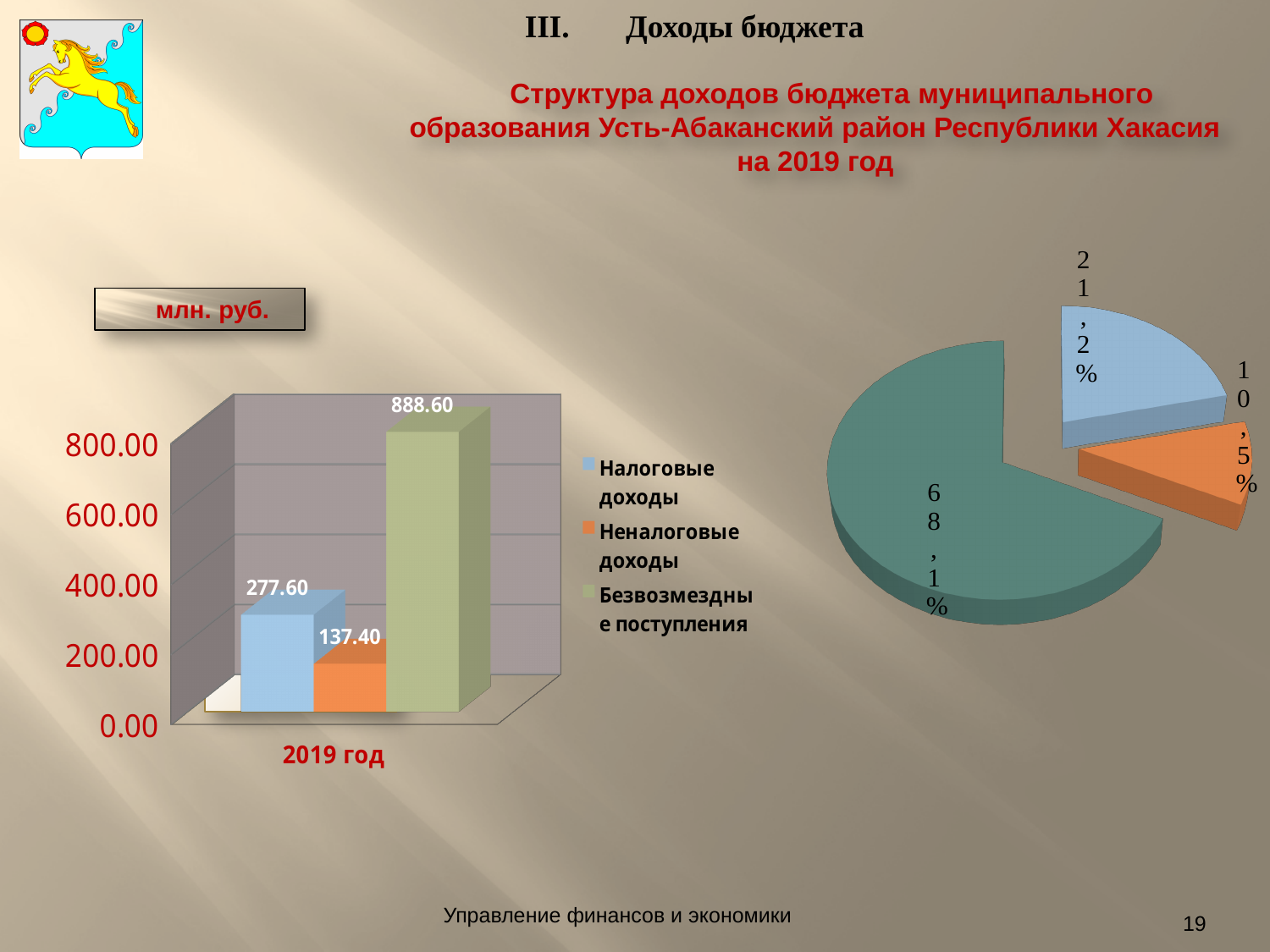
In the bar chart on the left, which is larger: Налоговые доходы or Неналоговые доходы? Налоговые доходы What kind of chart is shown on the right of the slide? Pie chart In the pie chart on the right, what share does the largest (teal) slice have? 68,1% In the bar chart on the left, what is the value for Безвозмездные поступления in 2019 год? 888.60 In the bar chart on the left, how many series does the legend list? 3 In the bar chart on the left, what is the value for Налоговые доходы in 2019 год? 277.60 In the bar chart on the left, what is the difference between Безвозмездные поступления and Налоговые доходы? 611.00 In the pie chart on the right, what share does the orange slice have? 10,5% In the bar chart on the left, which series has the highest value? Безвозмездные поступления In the bar chart on the left, what is the value for Неналоговые доходы in 2019 год? 137.40 What kind of chart is shown on the left of the slide? Bar chart In the bar chart on the left, which series has the lowest value? Неналоговые доходы